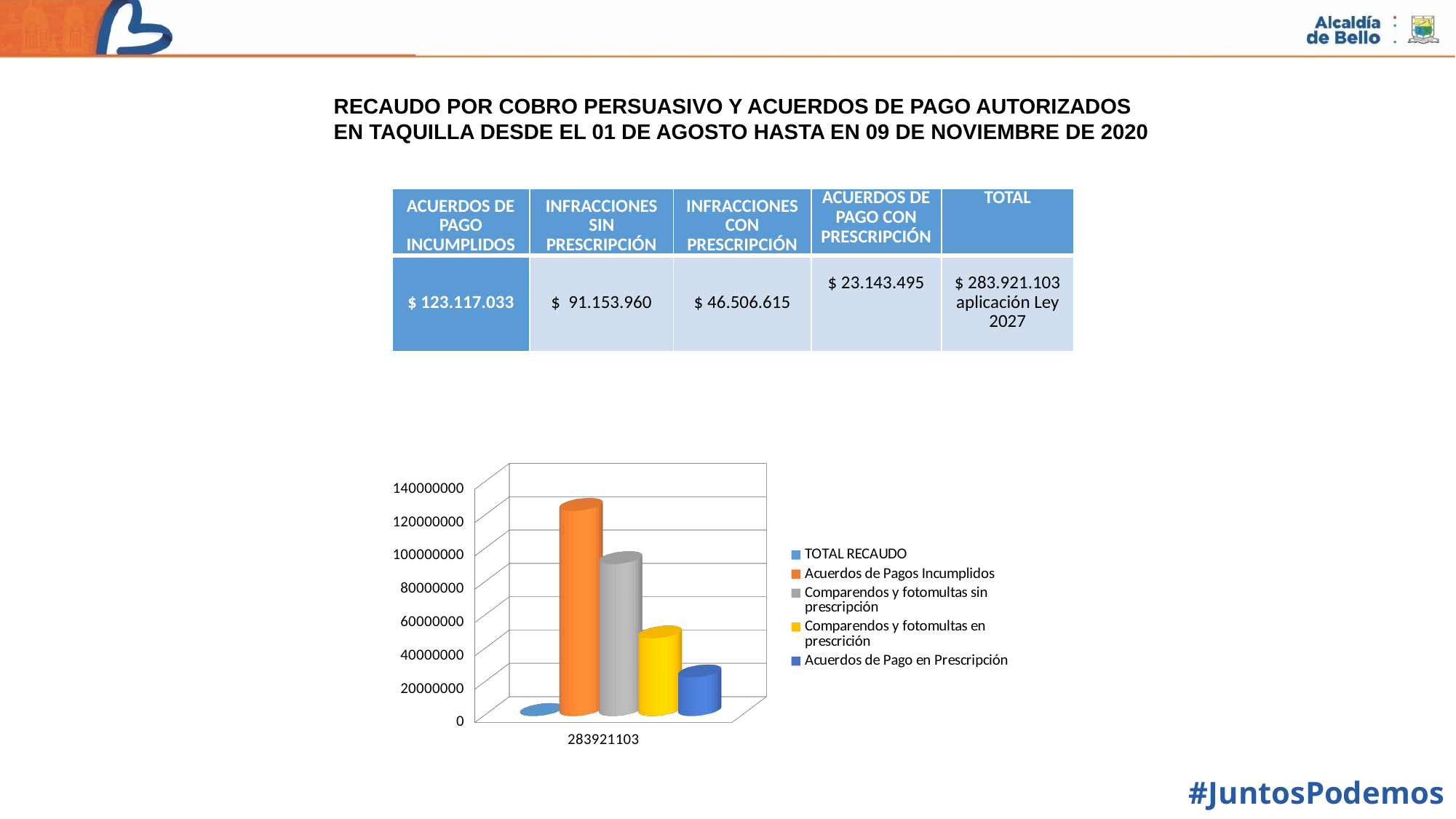
How many categories are shown on the x axis of the chart? 1 What is the category label shown on the x axis of the chart? 283921103 Is the value for Comparendos y fotomultas sin prescripción greater or less than 100000000? less How many series does the chart legend list? 5 Is the value for Acuerdos de Pago en Prescripción greater or less than 40000000? less Is the value for Acuerdos de Pagos Incumplidos greater or less than 100000000? greater Which is larger, the bar for Comparendos y fotomultas sin prescripción or the bar for Comparendos y fotomultas en prescrición? Comparendos y fotomultas sin prescripción Which series has the tallest bar in the chart? Acuerdos de Pagos Incumplidos Which is larger, the bar for Comparendos y fotomultas en prescrición or the bar for Acuerdos de Pago en Prescripción? Comparendos y fotomultas en prescrición What kind of chart is shown on the slide? bar chart What colour is the bar for Acuerdos de Pagos Incumplidos in the chart? orange